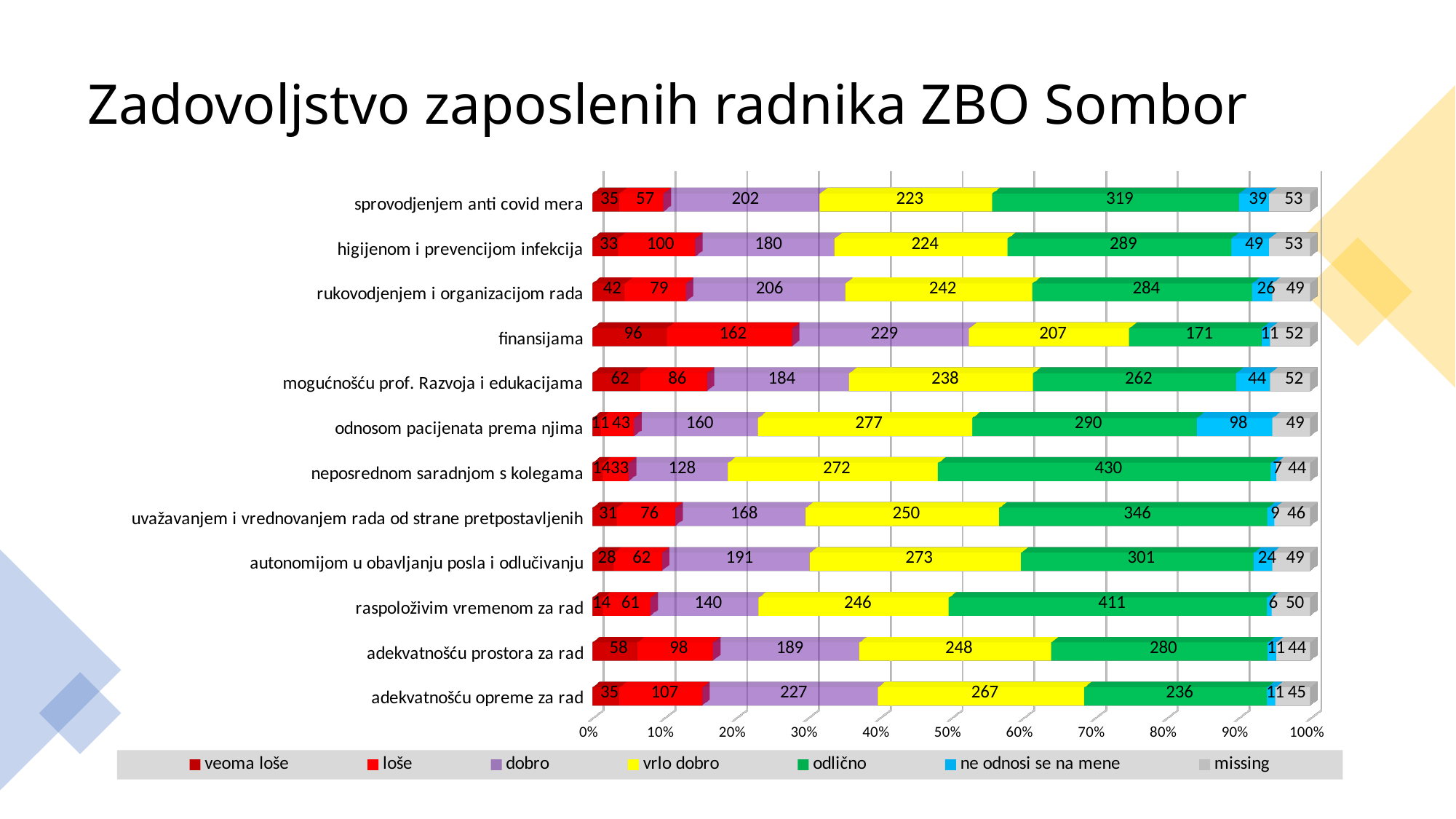
What is the value of the "odlično" series for "finansijama"? 171 What is the value of the "ne odnosi se na mene" series for "odnosom pacijenata prema njima"? 98 What kind of chart is shown on the slide? Stacked bar chart What is the difference between the "odlično" values for "raspoloživim vremenom za rad" and "finansijama"? 240 How many categories are shown on the chart? 12 Which category has the highest value in the "veoma loše" series? finansijama What is the total of all series for the "finansijama" bar? 928 Which category has the lowest value in the "odlično" series? finansijama Which is larger: the "loše" value for "higijenom i prevencijom infekcija" or for "rukovodjenjem i organizacijom rada"? higijenom i prevencijom infekcija How many series does the legend list? 7 What is the value of the "dobro" series for "sprovodjenjem anti covid mera"? 202 Which category has the highest value in the "odlično" series? neposrednom saradnjom s kolegama